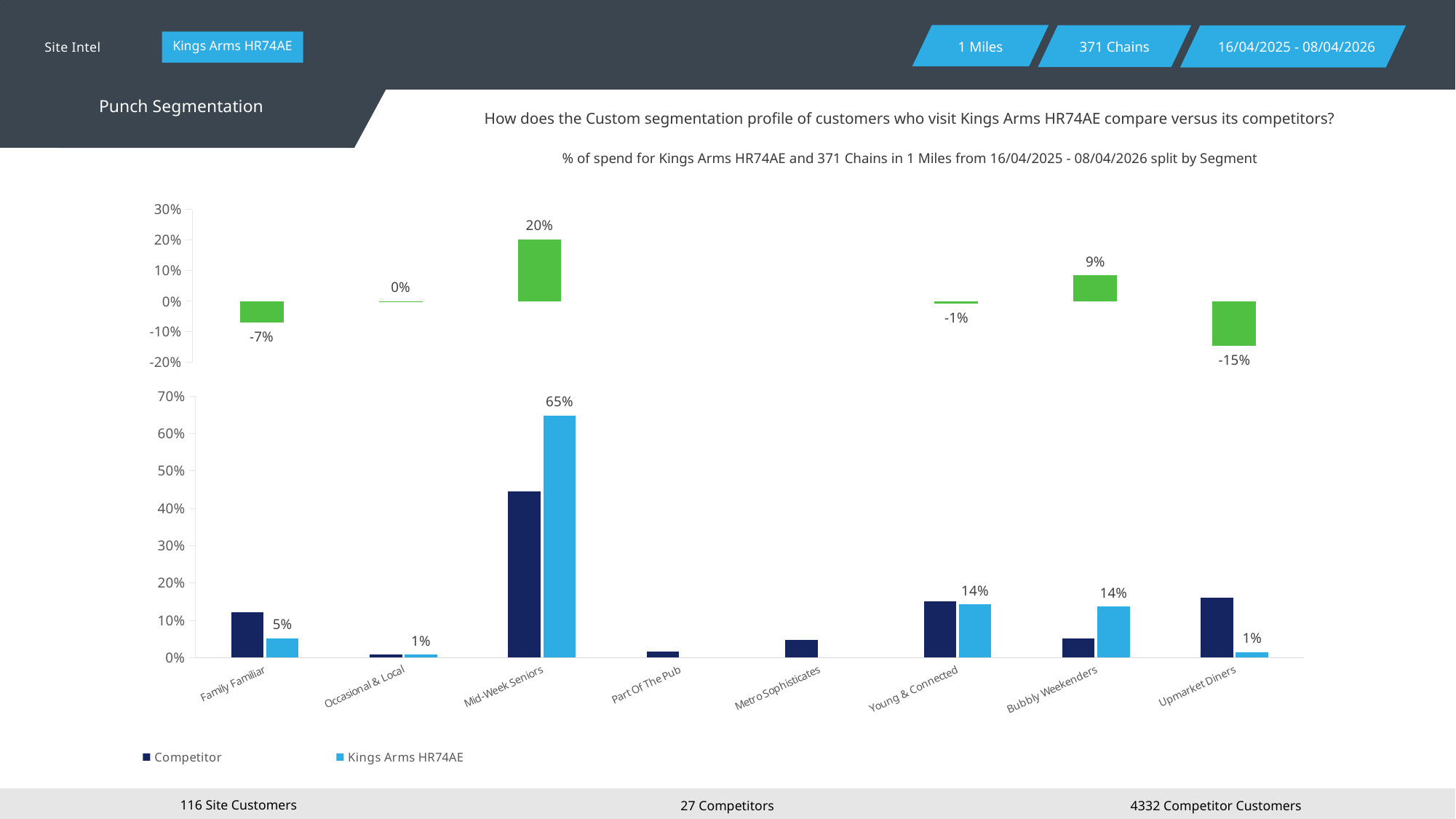
In the bottom chart, what is the value for Kings Arms HR74AE in the Mid-Week Seniors segment? 65% In the bottom chart, which is larger for Family Familiar: the Competitor value or the Kings Arms HR74AE value? Competitor In the top chart, what is the value shown for Bubbly Weekenders? 9% How many series does the legend of the bottom chart list? 2 In the top chart, which segment has the highest value? Mid-Week Seniors In the bottom chart, which segment has the highest Kings Arms HR74AE value? Mid-Week Seniors In the bottom chart, is the Competitor value for Mid-Week Seniors greater or less than 40%? greater In the bottom chart, what is the difference between the Kings Arms HR74AE values for Mid-Week Seniors and Young & Connected? 51% In the top chart, which segment has the lowest value? Upmarket Diners How many segments are shown on the x axis of the bottom chart? 8 In the top chart, what is the value shown for Upmarket Diners? -15% In the bottom chart, what is the value for Kings Arms HR74AE in the Family Familiar segment? 5%